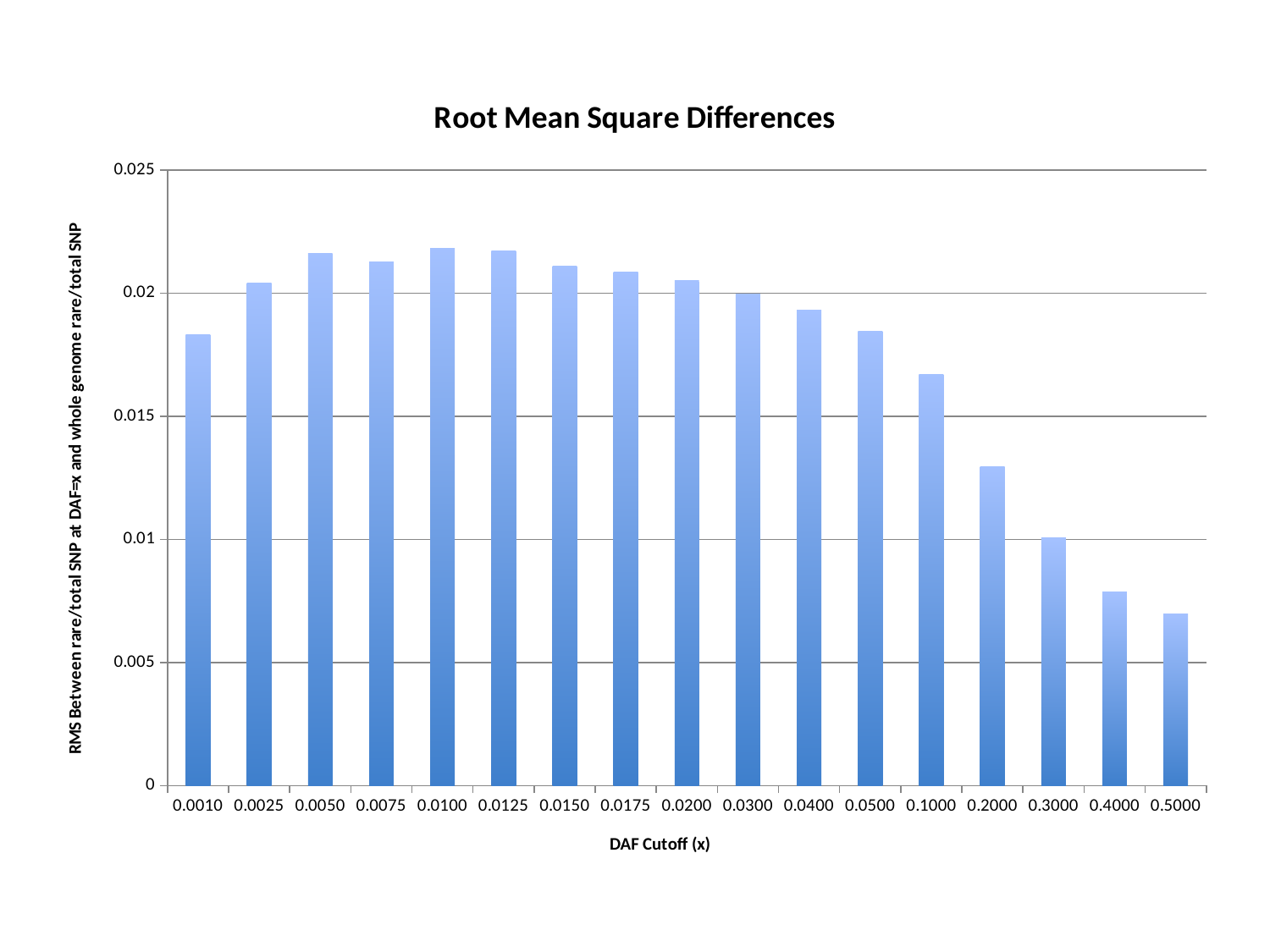
Is the value for DAF cutoff 0.0050 greater or less than 0.02? greater Is the value for DAF cutoff 0.0010 greater or less than 0.02? less What kind of chart is shown on the slide? bar chart Is the value for DAF cutoff 0.2000 greater or less than 0.015? less Which DAF cutoff has the lowest RMS value? 0.5000 What is the title of the chart? Root Mean Square Differences How many DAF cutoff categories are plotted on the x axis? 17 What is the label of the x axis? DAF Cutoff (x) Do the RMS values rise or fall along the x axis from DAF cutoff 0.0500 to 0.5000? fall Which has the larger RMS value, DAF cutoff 0.1000 or DAF cutoff 0.2000? 0.1000